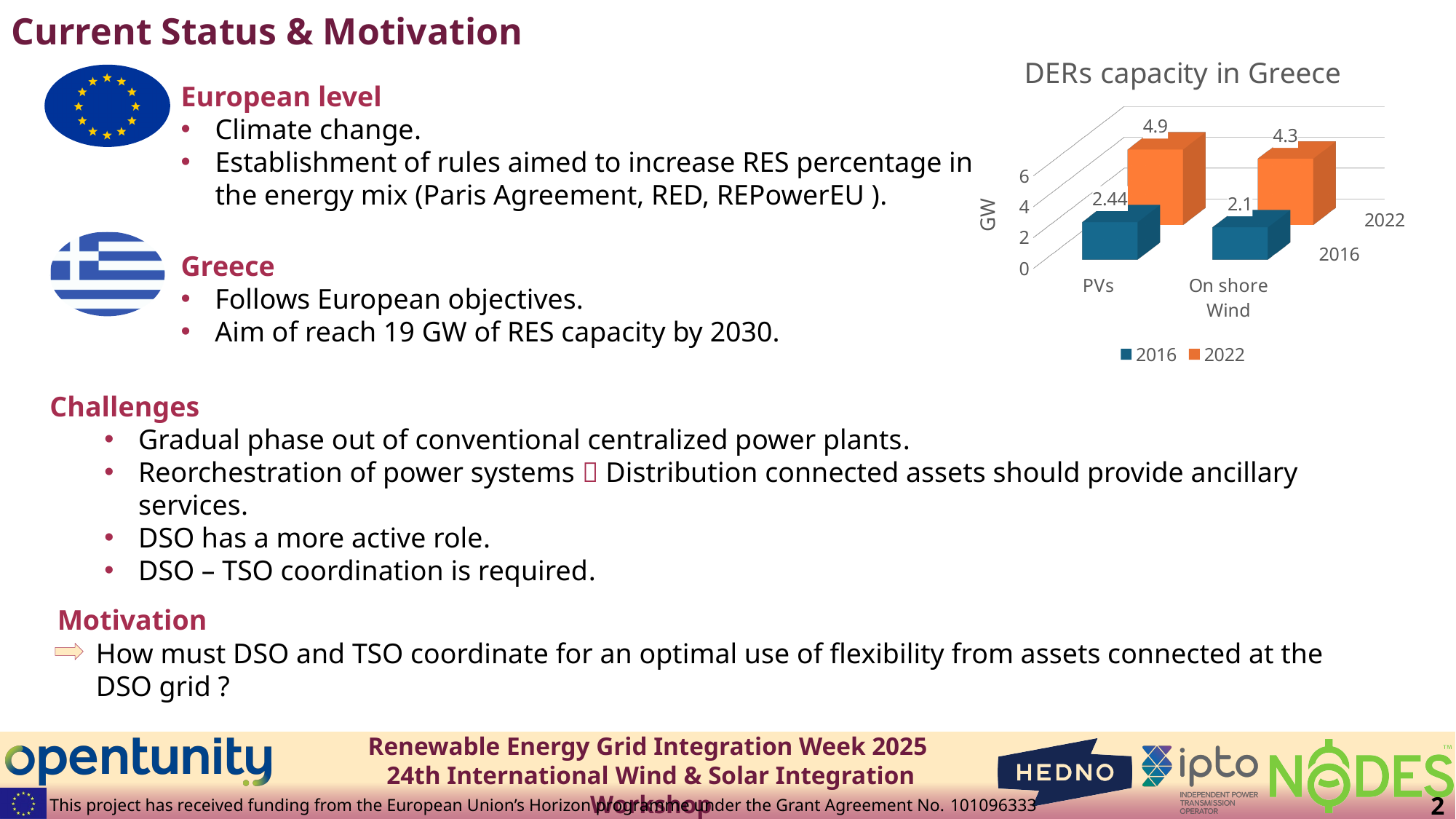
What is the title of the chart on the slide? DERs capacity in Greece Which category has the highest 2022 value in the DERs capacity chart? PVs What unit is shown on the vertical axis of the DERs capacity chart? GW What is the 2022 value for On shore Wind in the DERs capacity chart? 4.3 What is the 2016 value for On shore Wind in the DERs capacity chart? 2.1 By how much did PVs capacity increase from 2016 to 2022 according to the chart? 2.46 How many categories are shown on the x axis of the DERs capacity chart? 2 What is the 2022 value for PVs in the DERs capacity chart? 4.9 What is the 2016 value for PVs in the DERs capacity chart? 2.44 What type of chart is used to show DERs capacity in Greece? bar chart How many series does the legend of the DERs capacity chart list? 2 Which is larger in the DERs capacity chart: the 2016 value for PVs or the 2016 value for On shore Wind? PVs